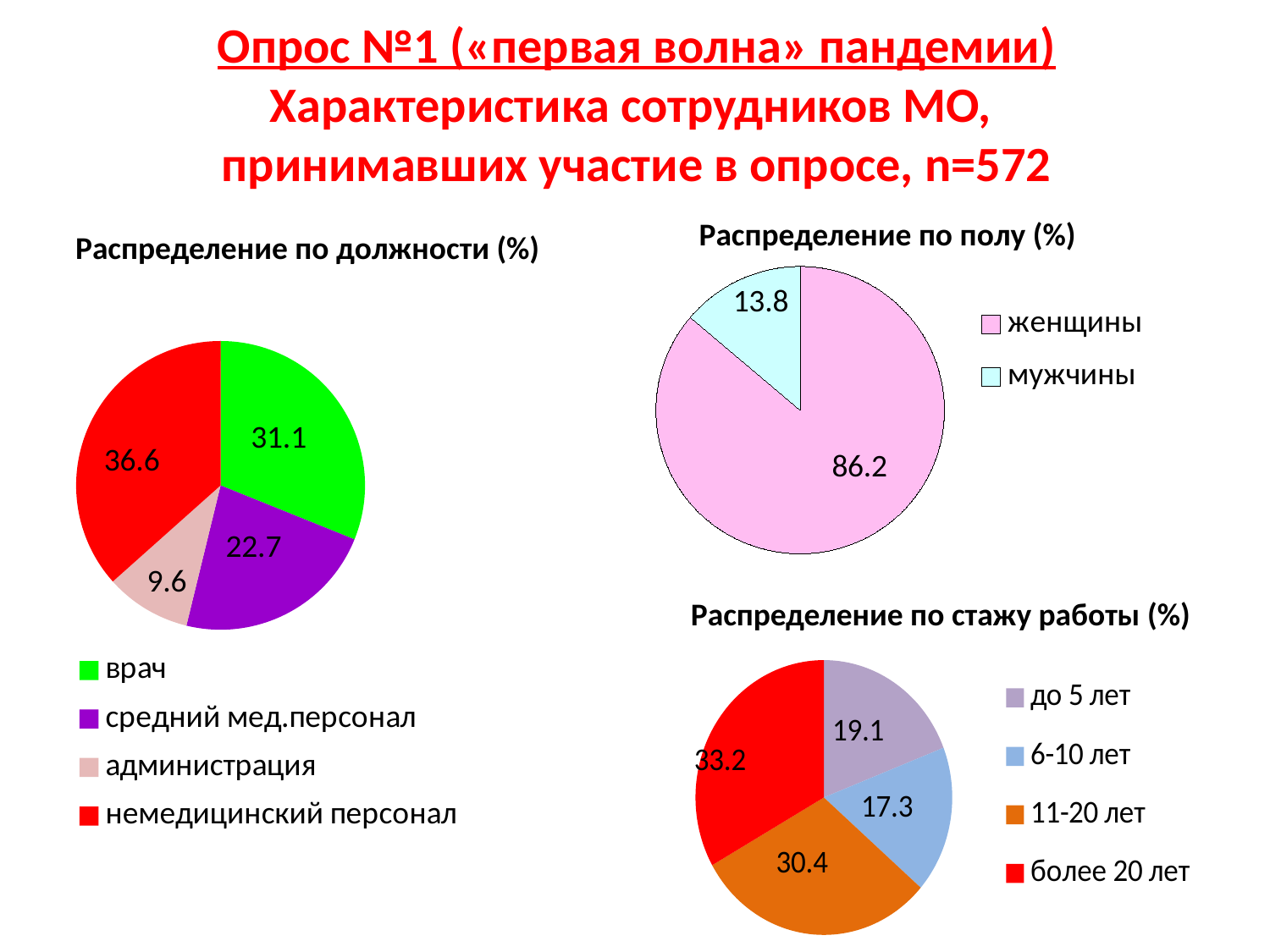
In the chart 'Распределение по должности (%)', what is the difference between немедицинский персонал and средний мед.персонал? 13.9 In the chart 'Распределение по стажу работы (%)', what colour is the slice for более 20 лет? red In the chart 'Распределение по должности (%)', what is the value for врач? 31.1 In the chart 'Распределение по должности (%)', which category has the smallest share? администрация In the chart 'Распределение по полу (%)', which is larger, женщины or мужчины? женщины In the chart 'Распределение по стажу работы (%)', what is the difference between более 20 лет and до 5 лет? 14.1 In the chart 'Распределение по должности (%)', which category has the largest share? немедицинский персонал In the chart 'Распределение по стажу работы (%)', which category has the smallest share? 6-10 лет In the chart 'Распределение по стажу работы (%)', what is the value for 11-20 лет? 30.4 In the chart 'Распределение по полу (%)', what is the value for мужчины? 13.8 In the chart 'Распределение по должности (%)', how many categories are shown? 4 What kind of chart is 'Распределение по полу (%)'? pie chart